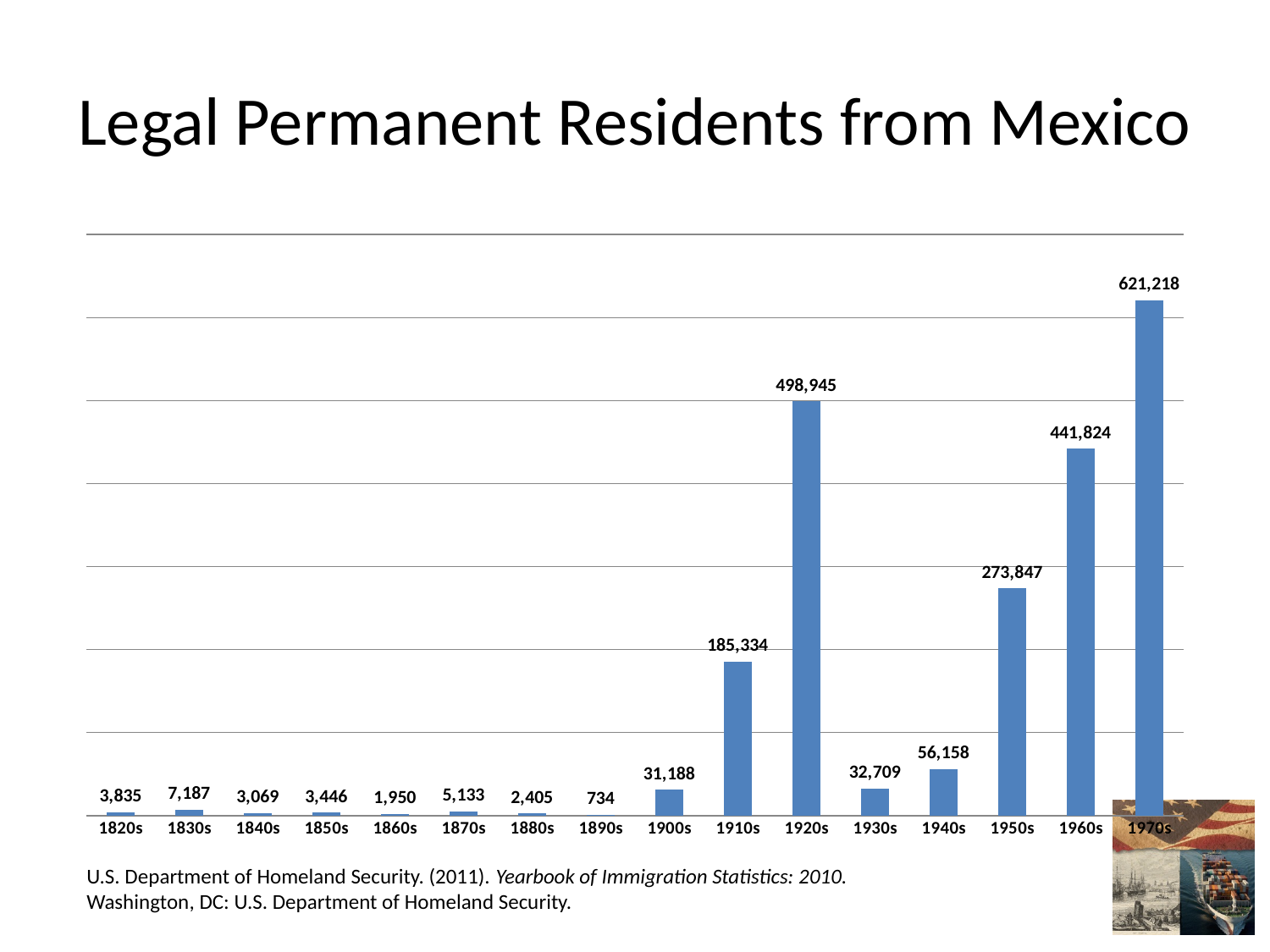
Which is larger, the value for the 1910s or the value for the 1950s? 1950s How many decades are shown on the x axis? 16 Do the values generally rise or fall from the 1940s to the 1970s? Rise What is the value for the 1890s? 734 What is the title of the slide? Legal Permanent Residents from Mexico What is the difference between the values for the 1970s and the 1960s? 179,394 What is the difference between the values for the 1940s and the 1930s? 23,449 What is the value for the 1920s? 498,945 Which decade has the highest value? 1970s What is the value for the 1950s? 273,847 What kind of chart is shown on the slide? Bar chart Which decade has the lowest value? 1890s